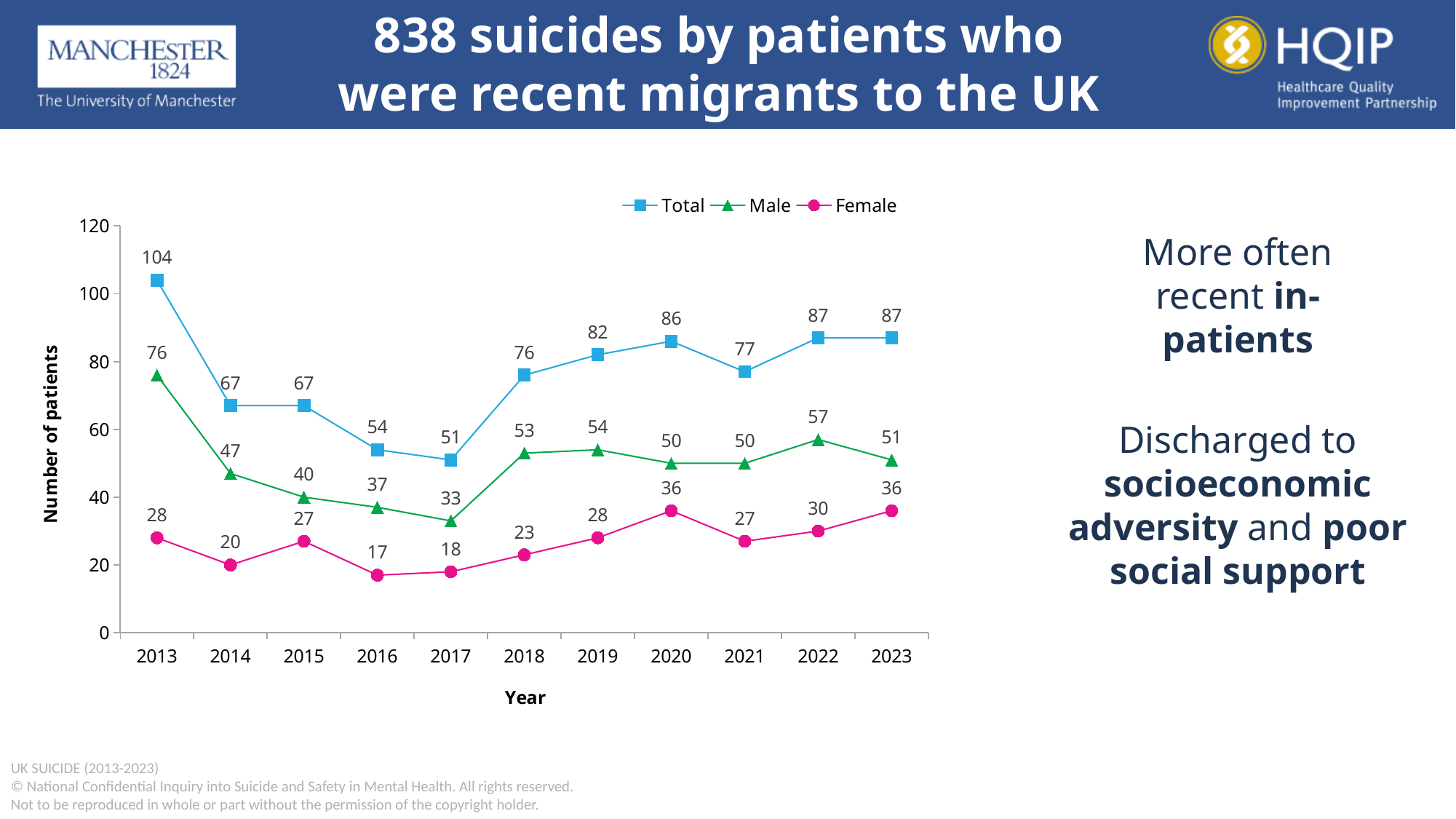
What is the difference between the Total values for 2013 and 2014? 37 What kind of chart is shown on the slide? line chart What is the Total value for 2013? 104 What is the Female value for 2016? 17 Is the Total value for 2020 greater or less than 80? greater In which year is the Total series lowest? 2017 How many series does the legend list? 3 In which year is the Total series highest? 2013 What is the Male value for 2022? 57 Which is larger, the Male value for 2019 or the Male value for 2020? Male value for 2019 How many years are shown on the x axis? 11 What is the label of the y axis? Number of patients